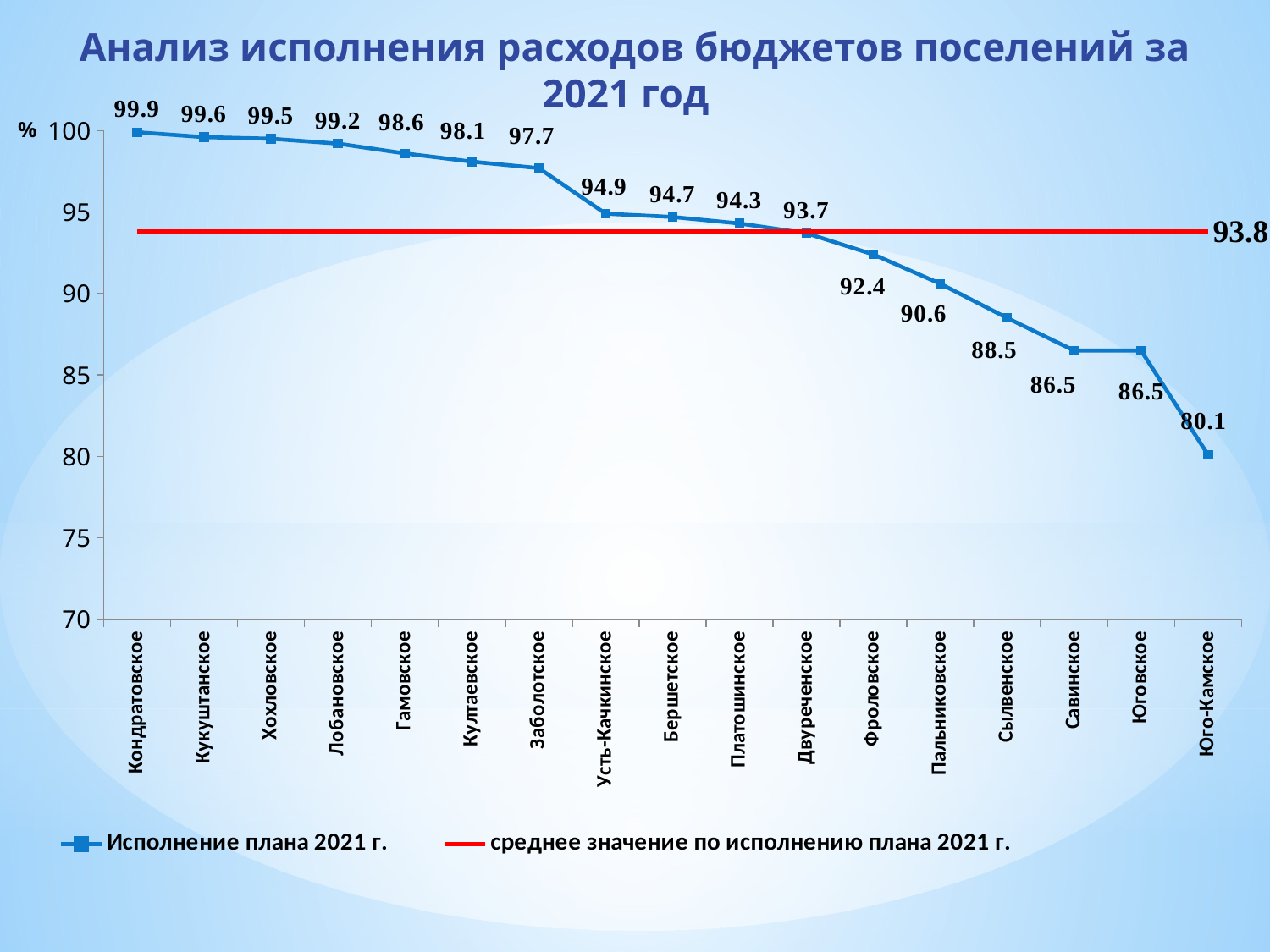
What kind of chart is this? line chart Which settlement has the highest value? Кондратовское How many series does the legend list? 2 What is the value of the red average line (среднее значение по исполнению плана 2021 г.)? 93.8 What is the difference between the values for Кондратовское and Юго-Камское? 19.8 How many settlements are shown on the x axis? 17 What is the value for Фроловское? 92.4 Which settlement has the lowest value? Юго-Камское What is the value for Кондратовское? 99.9 Which is larger, the value for Заболотское or the value for Усть-Качкинское? Заболотское What is the value for Юго-Камское? 80.1 Do the values rise or fall from left to right along the x axis? fall